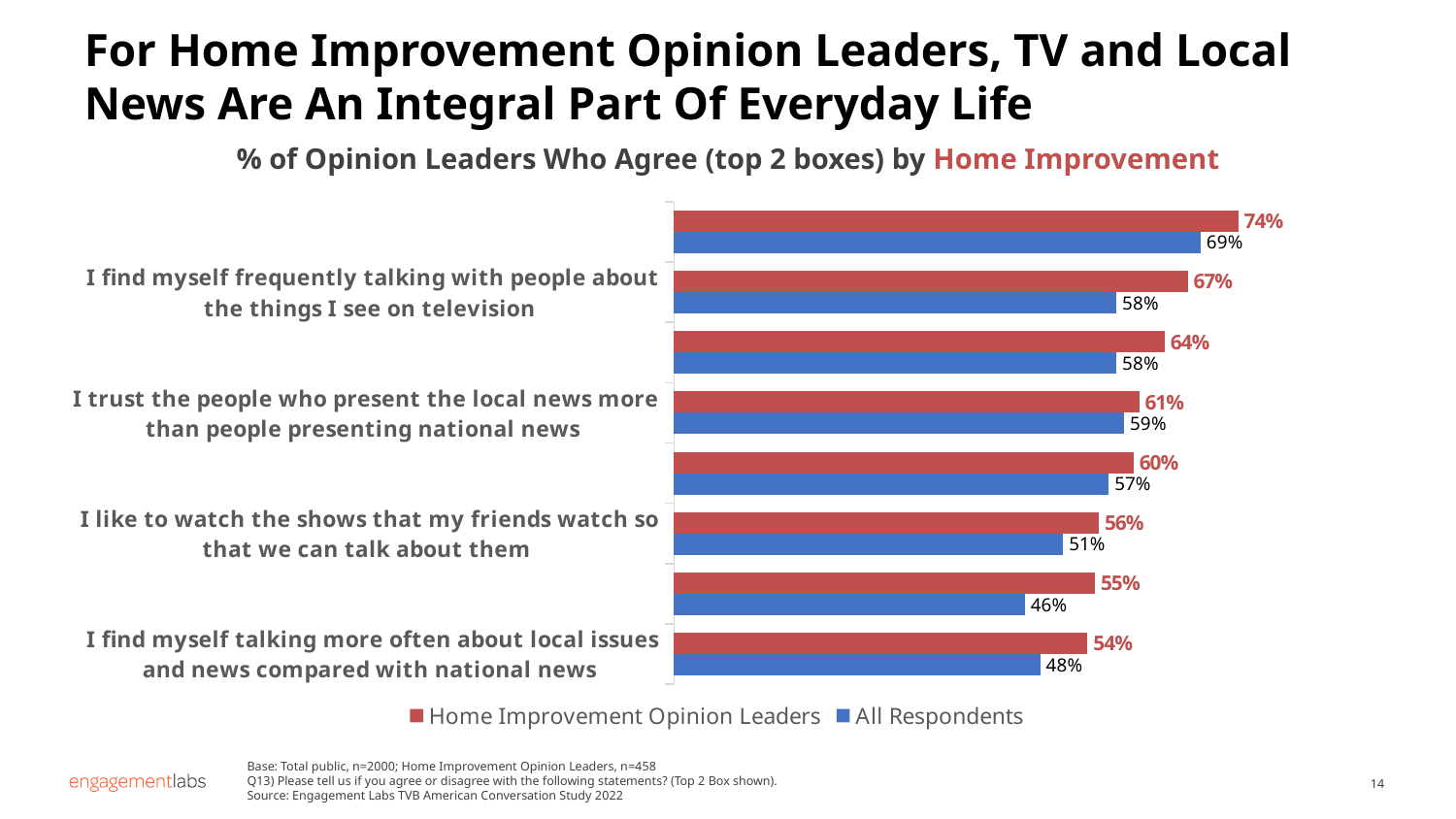
What is the value for Home Improvement Opinion Leaders for "I find myself frequently talking with people about the things I see on television"? 67% What is the difference between Home Improvement Opinion Leaders and All Respondents for "I find myself frequently talking with people about the things I see on television"? 9 percentage points For "I like to watch the shows that my friends watch so that we can talk about them", which series has the larger value, Home Improvement Opinion Leaders or All Respondents? Home Improvement Opinion Leaders What is the value for All Respondents for "I trust the people who present the local news more than people presenting national news"? 59% What kind of chart is shown on the slide? bar chart How many series does the legend list? 2 What is the highest value shown for Home Improvement Opinion Leaders in the chart? 74% What are the two series named in the legend? Home Improvement Opinion Leaders and All Respondents How many statements (pairs of bars) are plotted in the chart? 8 What is the lowest value shown for All Respondents in the chart? 46% What is the value for All Respondents for "I find myself talking more often about local issues and news compared with national news"? 48% What is the value for Home Improvement Opinion Leaders for "I like to watch the shows that my friends watch so that we can talk about them"? 56%